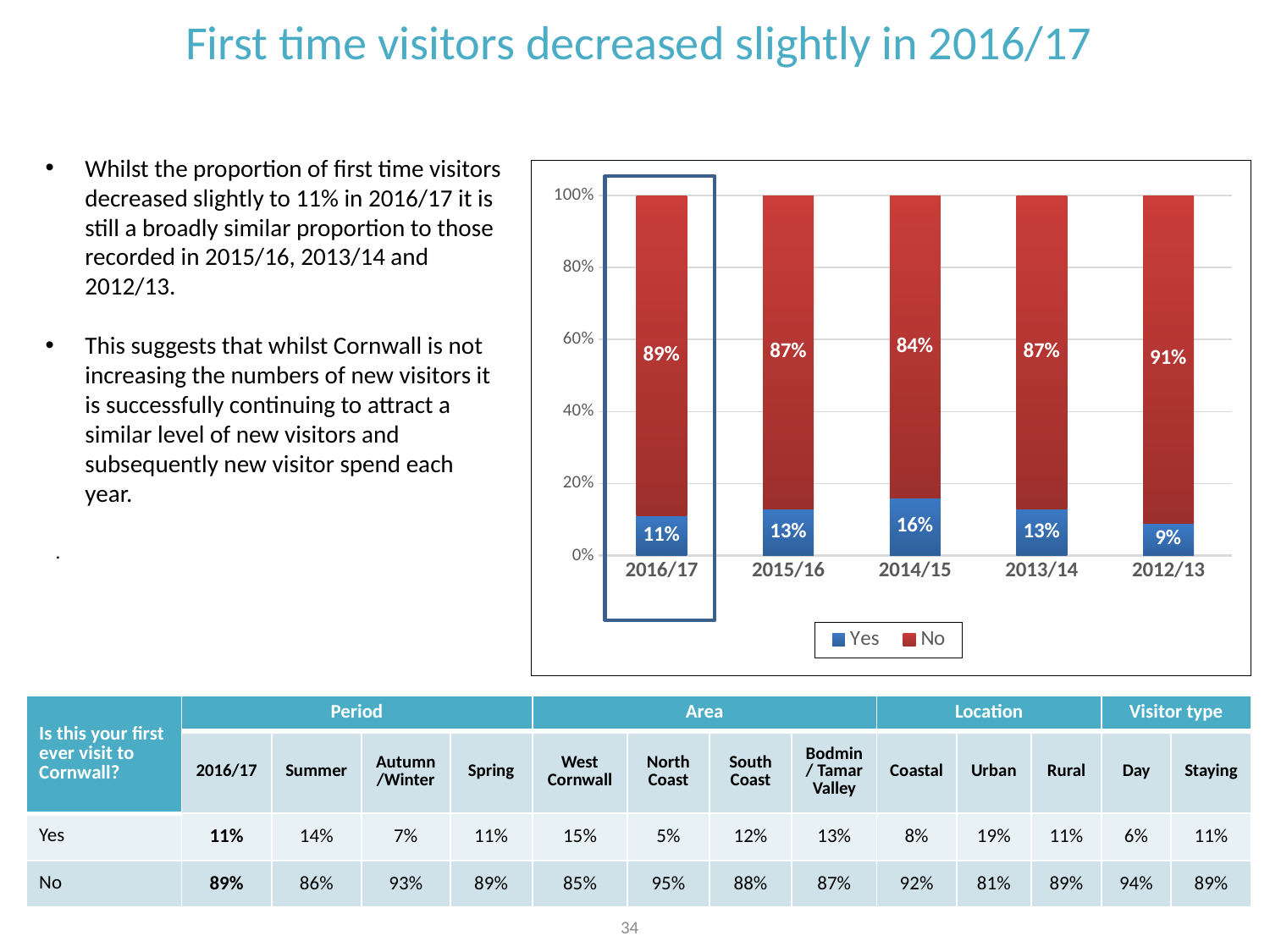
What is the difference between the Yes values for 2014/15 and 2016/17? 5% What kind of chart is shown? stacked bar chart What is the value for Yes in 2016/17? 11% What is the value for Yes in 2012/13? 9% Is the value for Yes in 2014/15 greater or less than 20%? less What is the value for No in 2014/15? 84% Which is larger, the No value for 2012/13 or the No value for 2015/16? 2012/13 What is the total of the stacked bar for 2013/14? 100% How many series does the legend list? 2 Which year has the highest value for Yes? 2014/15 Which year has the lowest value for Yes? 2012/13 How many years are shown on the x axis? 5